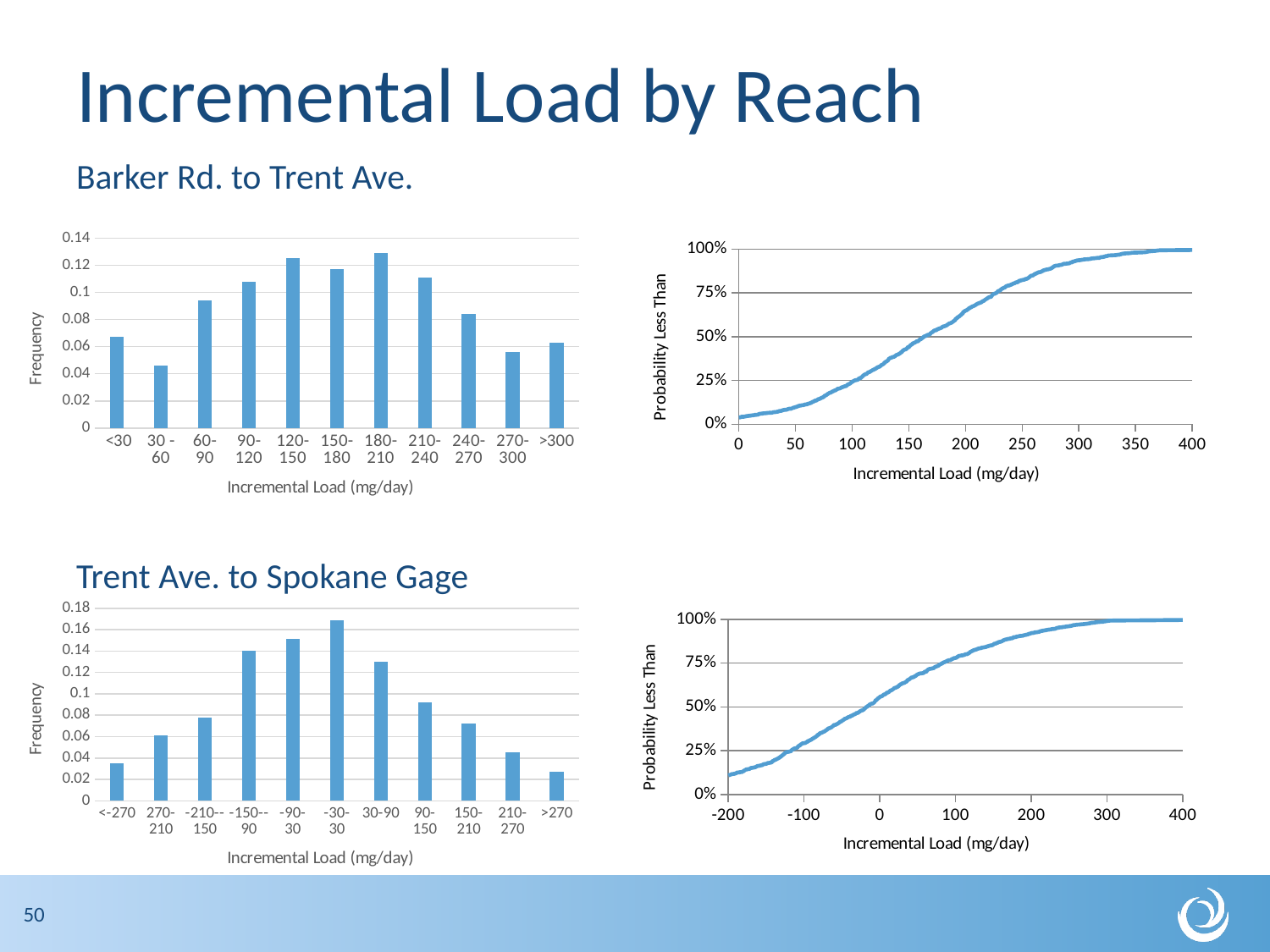
In the bottom-left bar chart (Trent Ave. to Spokane Gage), is the frequency for the '150-210' category greater or less than 0.08? less What kind of chart is the top-left chart under 'Barker Rd. to Trent Ave.'? bar chart In the top-left bar chart (Barker Rd. to Trent Ave.), which has the higher frequency: '60-90' or '240-270'? 60-90 In the top-right line chart (Barker Rd. to Trent Ave.), is the probability at an incremental load of 200 mg/day greater or less than 50%? greater In the top-left bar chart (Barker Rd. to Trent Ave.), which category has the lowest frequency? 30 - 60 In the top-left bar chart (Barker Rd. to Trent Ave.), is the frequency for the '<30' category greater or less than 0.06? greater In the top-left bar chart (Barker Rd. to Trent Ave.), how many incremental load categories are shown on the x axis? 11 In the bottom-left bar chart (Trent Ave. to Spokane Gage), which category has the highest frequency? -30-30 In the bottom-left bar chart (Trent Ave. to Spokane Gage), which has the higher frequency: '-150--90' or '90-150'? -150--90 What is the y-axis label of the bottom-right line chart (Trent Ave. to Spokane Gage)? Probability Less Than In the bottom-right line chart (Trent Ave. to Spokane Gage), does the probability rise or fall as incremental load increases along the x axis? rise